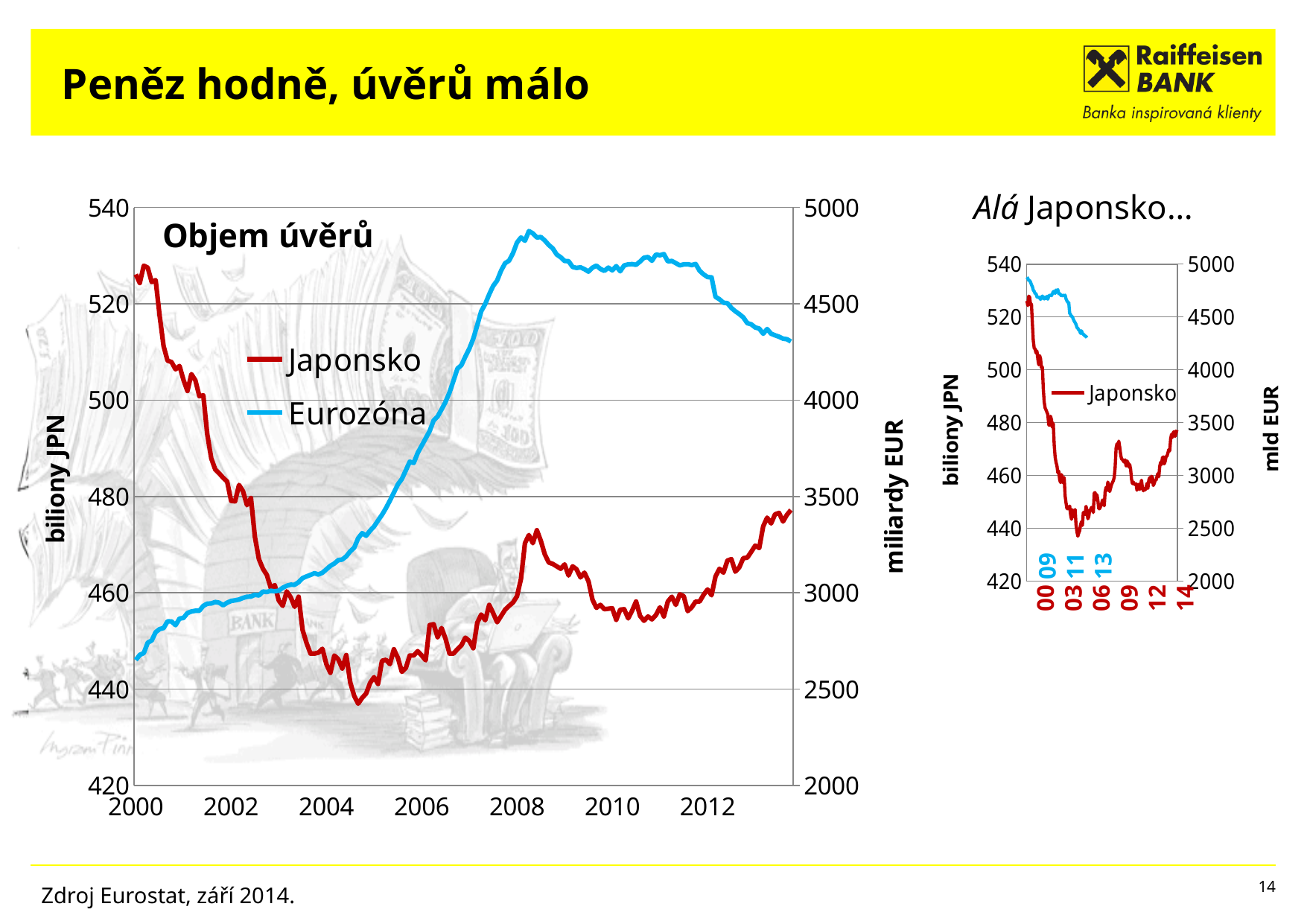
How many series does the legend of the 'Objem úvěrů' chart list? 2 In the 'Objem úvěrů' chart, what colour is the Eurozóna line? blue In the 'Objem úvěrů' chart, does the Japonsko line rise or fall between 2000 and 2004? fall How many series does the legend of the 'Alá Japonsko...' chart list? 1 In the 'Objem úvěrů' chart, is the Japonsko value in 2000 greater or less than 500? greater In the 'Objem úvěrů' chart, is the Eurozóna value in 2008 greater or less than 4500? greater In the 'Objem úvěrů' chart, is the Eurozóna value in 2000 greater or less than 3000? less In the 'Objem úvěrů' chart, does the Eurozóna line rise or fall between 2000 and 2008? rise What kind of chart is the 'Alá Japonsko...' chart on the right? line chart In the 'Objem úvěrů' chart, what is the label of the left vertical axis? biliony JPN What kind of chart is the 'Objem úvěrů' chart? line chart